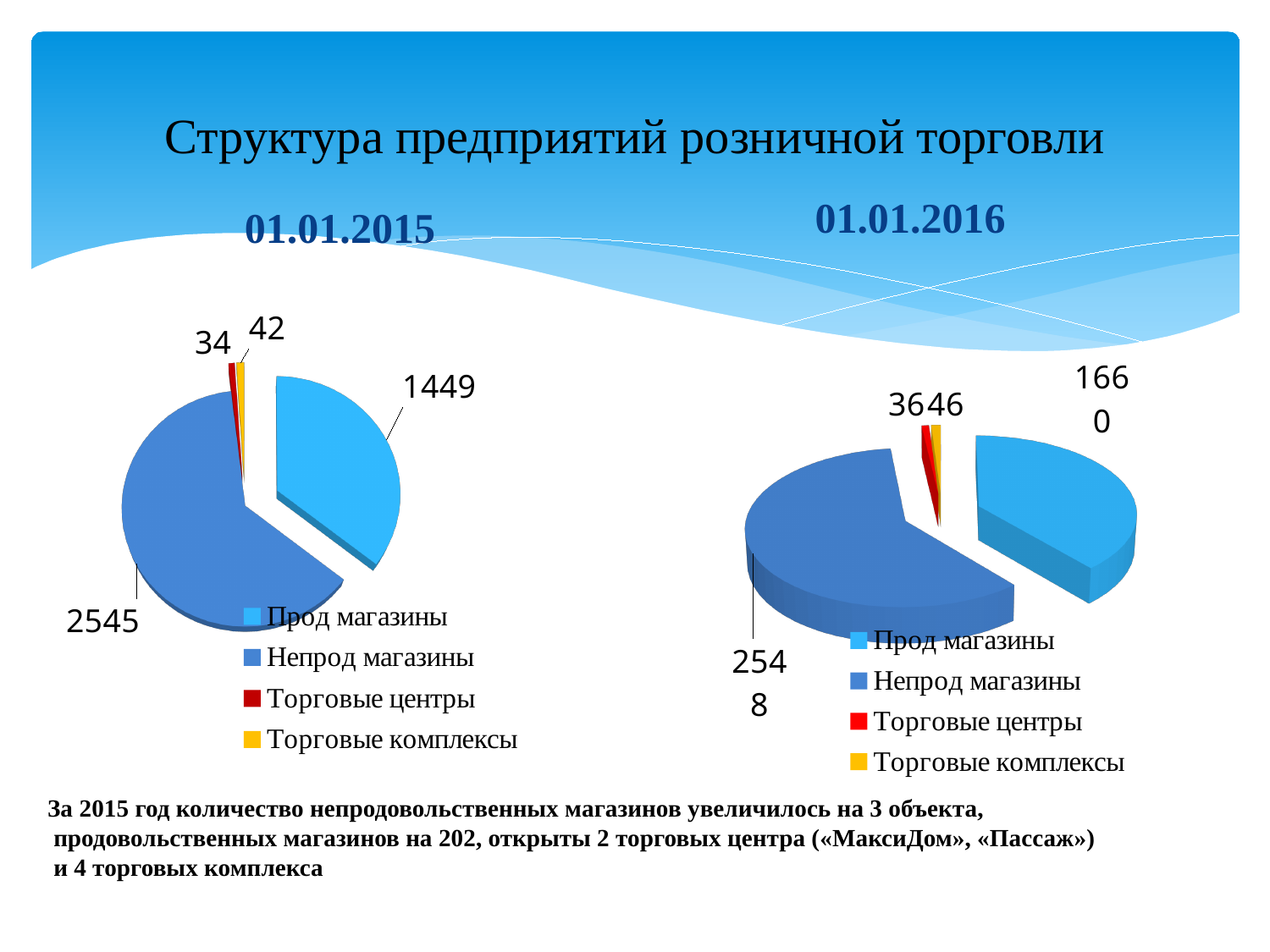
In the 01.01.2016 chart, what is the value for Непрод магазины? 2548 In the 01.01.2016 chart, which is larger: Торговые центры or Торговые комплексы? Торговые комплексы In the 01.01.2015 chart, which category has the smallest slice? Торговые центры In the 01.01.2016 chart, what is the value for Торговые комплексы? 46 In the 01.01.2015 chart, what is the value for Непрод магазины? 2545 How many categories does the legend of the 01.01.2016 chart list? 4 In the 01.01.2016 chart, which category has the largest slice? Непрод магазины In the 01.01.2015 chart, what is the value for Торговые центры? 34 In the 01.01.2015 chart, what is the value for Прод магазины? 1449 In the 01.01.2015 chart, what is the difference between Непрод магазины and Прод магазины? 1096 What is the total of all slices in the 01.01.2015 chart? 4070 What kind of chart is used on the 01.01.2015 side of the slide? pie chart